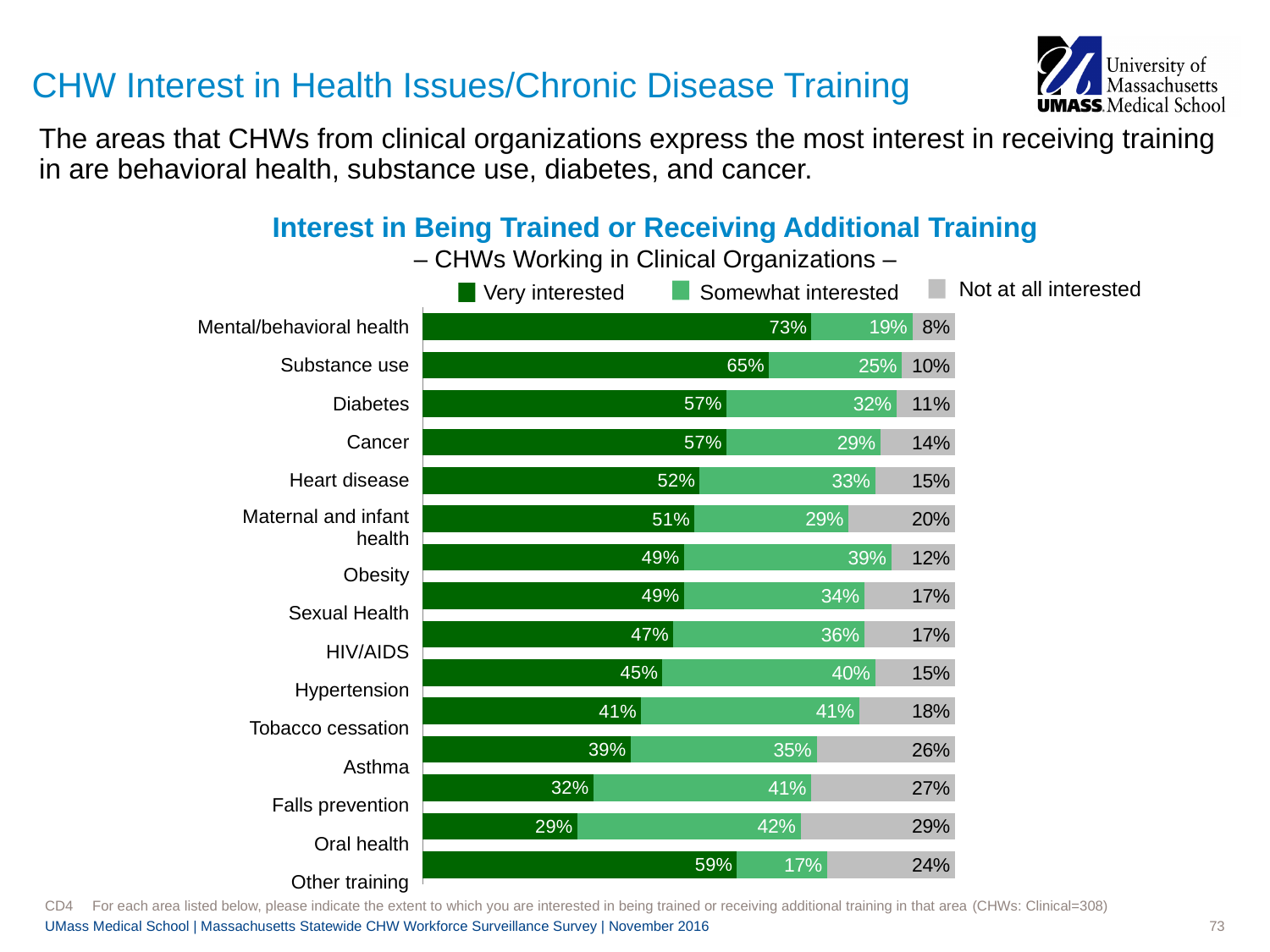
Which training area has the lowest share of CHWs who are very interested? Oral health What type of chart is shown on the slide? Stacked bar chart How many series does the legend list? 3 Which training area has the highest share of CHWs who are very interested? Mental/behavioral health What percentage of CHWs are very interested in training on mental/behavioral health? 73% What is the difference between the very interested percentages for substance use and diabetes? 8% How many training areas are listed in the chart? 15 What percentage of CHWs are not at all interested in training on oral health? 29% Which legend entry is shown in light grey? Not at all interested Which has a larger somewhat interested percentage, obesity or sexual health? Obesity What is the total of the very interested and somewhat interested percentages for cancer? 86% What percentage of CHWs are somewhat interested in training on hypertension? 40%